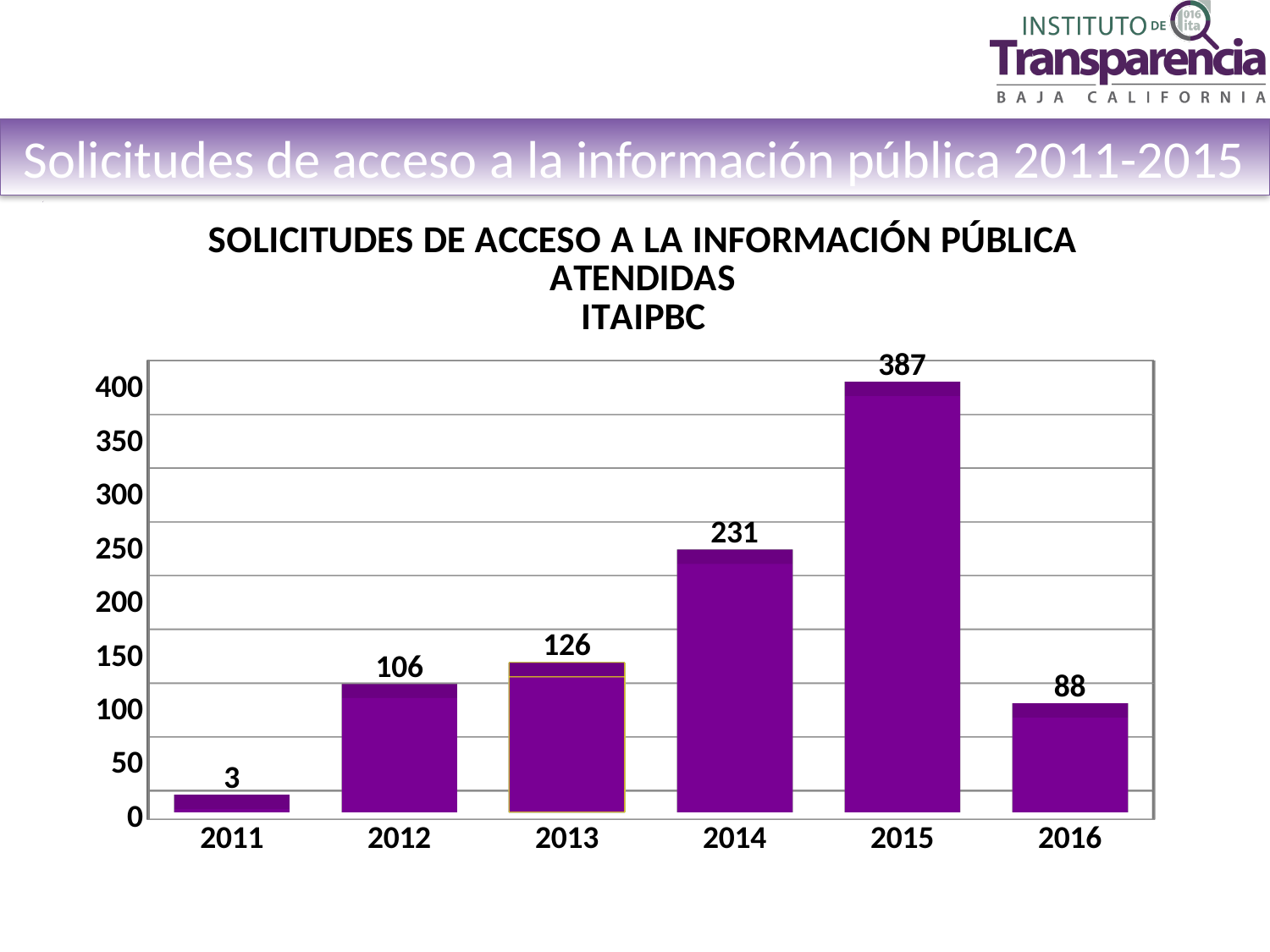
What kind of chart is shown on the slide? bar chart How many years are shown on the x axis? 6 What is the difference between the values for 2013 and 2012? 20 What is the difference between the values for 2015 and 2014? 156 What is the value for 2013? 126 What is the value for 2015? 387 Which is larger, the value for 2012 or the value for 2016? 2012 Do the values rise or fall from 2011 to 2015? rise Which year has the highest value? 2015 What is the value for 2011? 3 Is the value for 2014 greater or less than 200? greater Which year has the lowest value? 2011